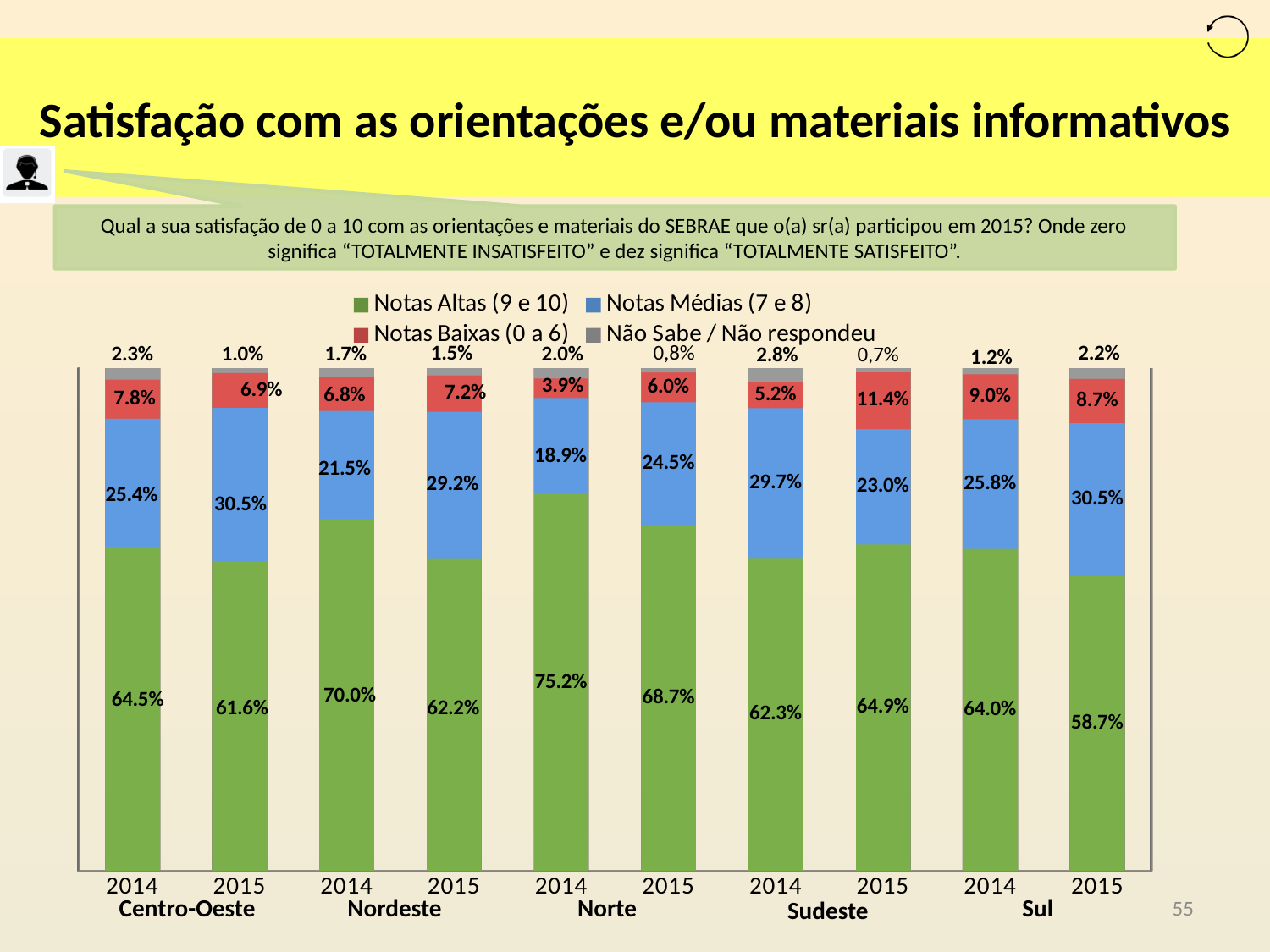
By how many percentage points did Notas Altas (9 e 10) for Nordeste change from 2014 to 2015? 7.8 percentage points What is the total of the Centro-Oeste 2014 stacked bar? 100.0% What kind of chart is shown on the slide? Stacked bar chart Which is larger: Notas Altas (9 e 10) for Sudeste in 2014 or in 2015? 2015 What percentage of Notas Altas (9 e 10) is shown for Norte in 2014? 75.2% Which bar has the highest Notas Baixas (0 a 6) share? Sudeste 2015 What is the Notas Médias (7 e 8) value for Centro-Oeste in 2015? 30.5% What is the value of Notas Baixas (0 a 6) for Sudeste in 2015? 11.4% Which bar has the lowest Notas Altas (9 e 10) share? Sul 2015 Which bar has the highest Notas Altas (9 e 10) share? Norte 2014 How many series does the legend list? 4 How many bars are plotted in the chart? 10